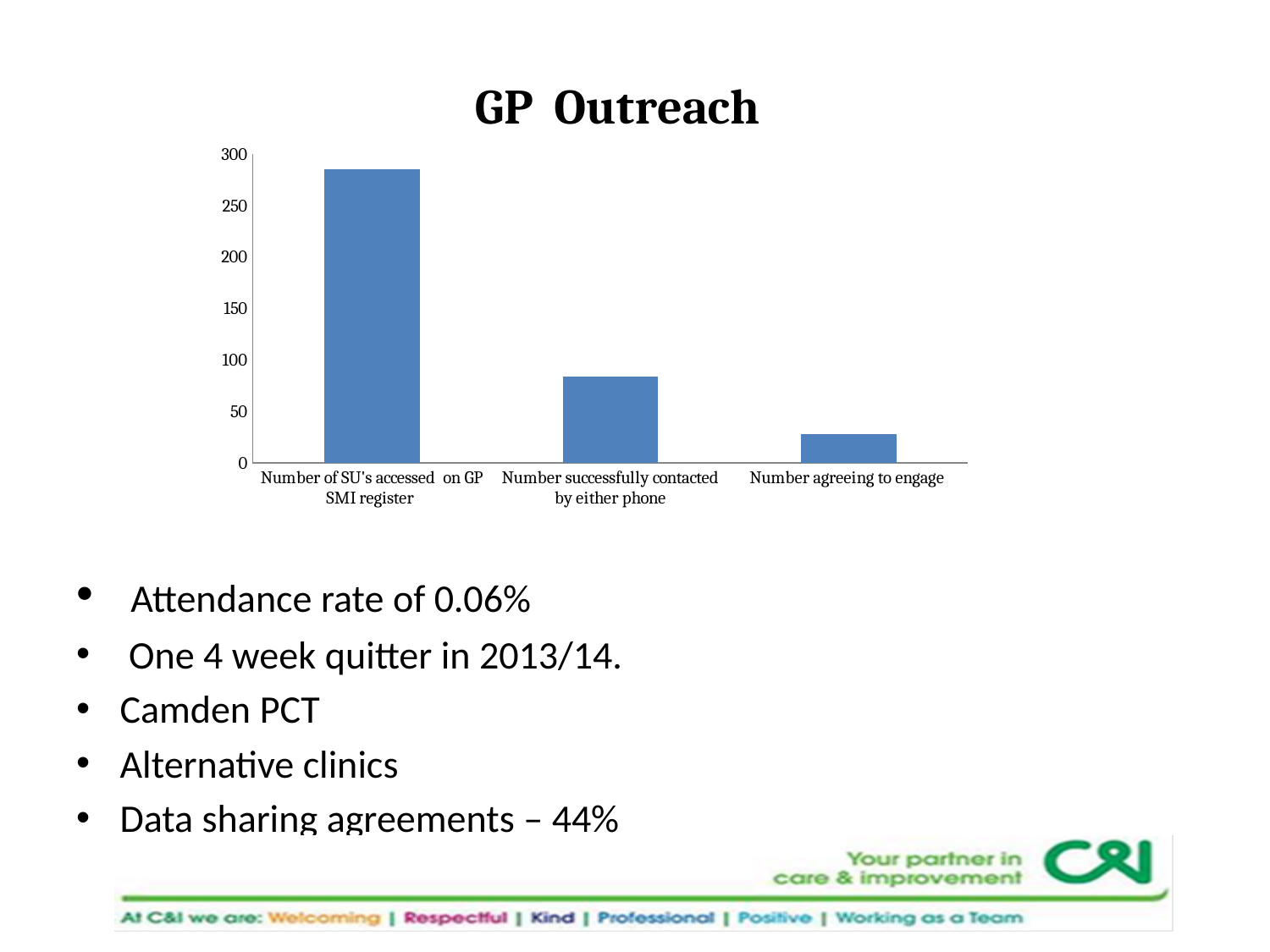
Is the value for "Number of SU's accessed on GP SMI register" greater or less than 250? greater Which category has the highest value in the chart? Number of SU's accessed on GP SMI register What is the title shown above the chart? GP Outreach Do the bar values rise or fall from left to right across the categories? fall Is the value for "Number agreeing to engage" greater or less than 50? less Which is larger: the value for "Number successfully contacted by either phone" or the value for "Number agreeing to engage"? Number successfully contacted by either phone Is the value for "Number successfully contacted by either phone" greater or less than 50? greater Which category has the lowest value in the chart? Number agreeing to engage What kind of chart is shown on the slide? bar chart How many categories are plotted in the chart? 3 What is the maximum value shown on the vertical axis of the chart? 300